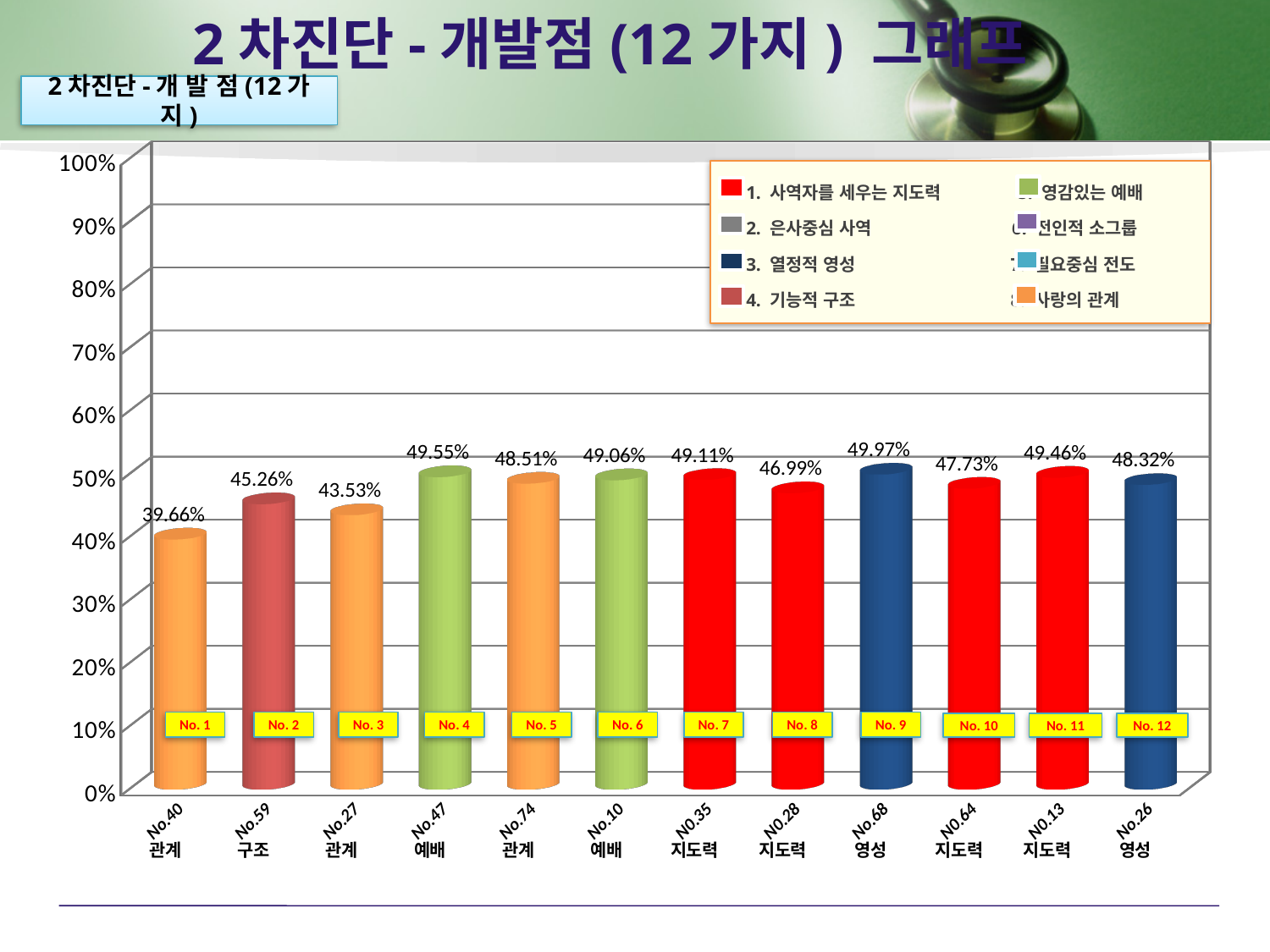
How many bars are plotted in the chart? 12 Which bar has the highest value? No.68 영성 (No. 9) What is the value of the bar labelled No. 8 (N0.28 지도력)? 46.99% How many entries does the chart legend list? 8 Which is larger, the value for No.27 관계 (No. 3) or the value for No.74 관계 (No. 5)? No.74 관계 (No. 5) What is the value of the bar for No.68 영성 (No. 9)? 49.97% What is the value of the bar labelled No. 1 (No.40 관계)? 39.66% What is the difference between the values for No.59 구조 (No. 2) and No.40 관계 (No. 1)? 5.60% What type of chart is shown on the slide? bar chart Which bar has the lowest value? No.40 관계 (No. 1) Is the value for No.40 관계 (No. 1) greater or less than 40%? less What is the value of the bar for No.47 예배 (No. 4)? 49.55%